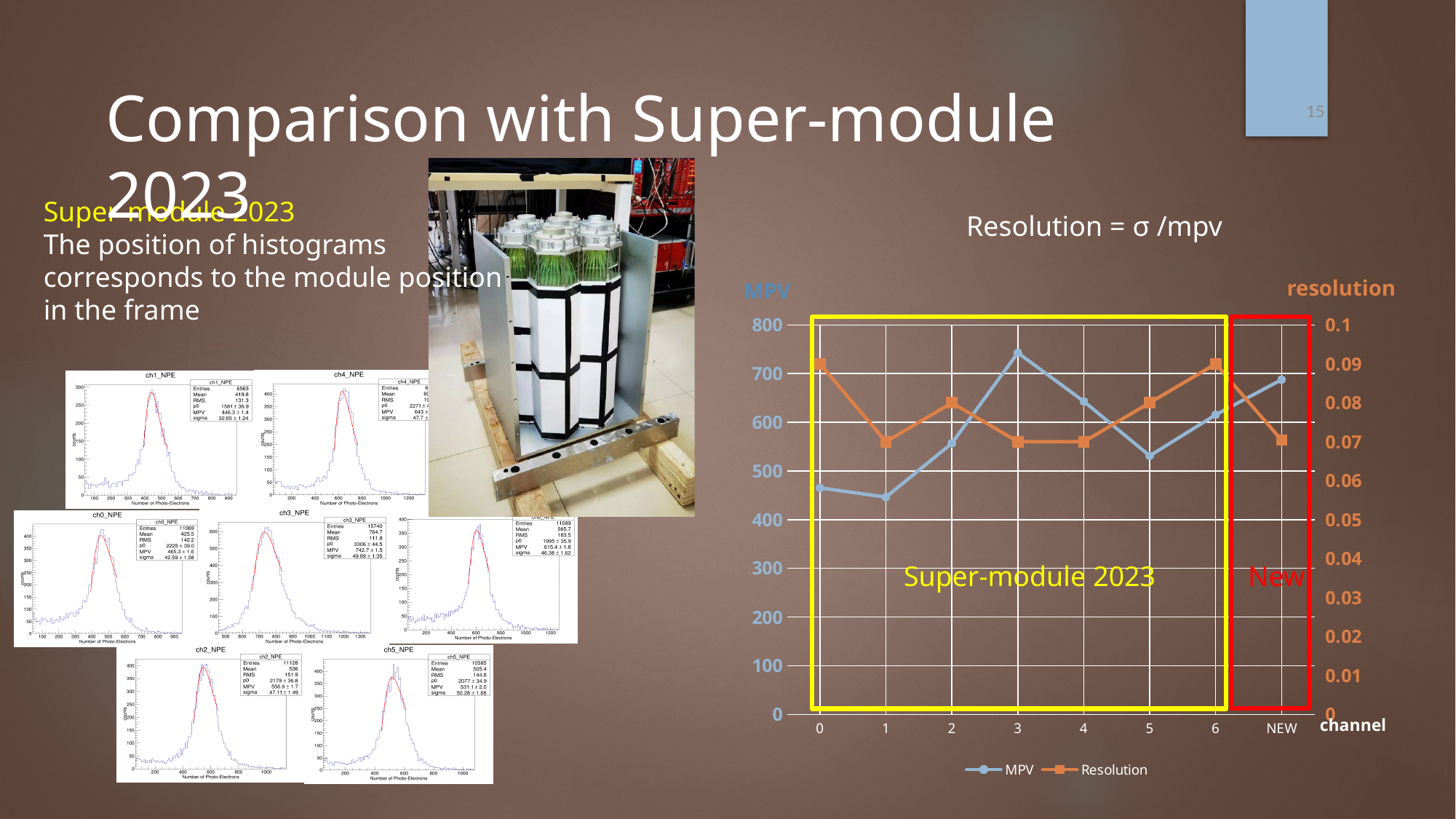
Is the Resolution value for channel 0 greater or less than 0.08? greater What kind of chart is shown on the right side of the slide? line chart How many series does the legend of the chart list? 2 Is the MPV value for channel 3 greater or less than 700? greater How many channel categories are plotted along the x axis of the chart? 8 Does the MPV series rise or fall from channel 1 to channel 3? rise Which channel has the highest MPV value in the chart? 3 What are the two entries listed in the chart's legend? MPV and Resolution Which has the larger MPV value, channel 3 or channel 5? channel 3 Which channel has the lowest MPV value in the chart? 1 Is the MPV value for the NEW channel greater or less than 600? greater